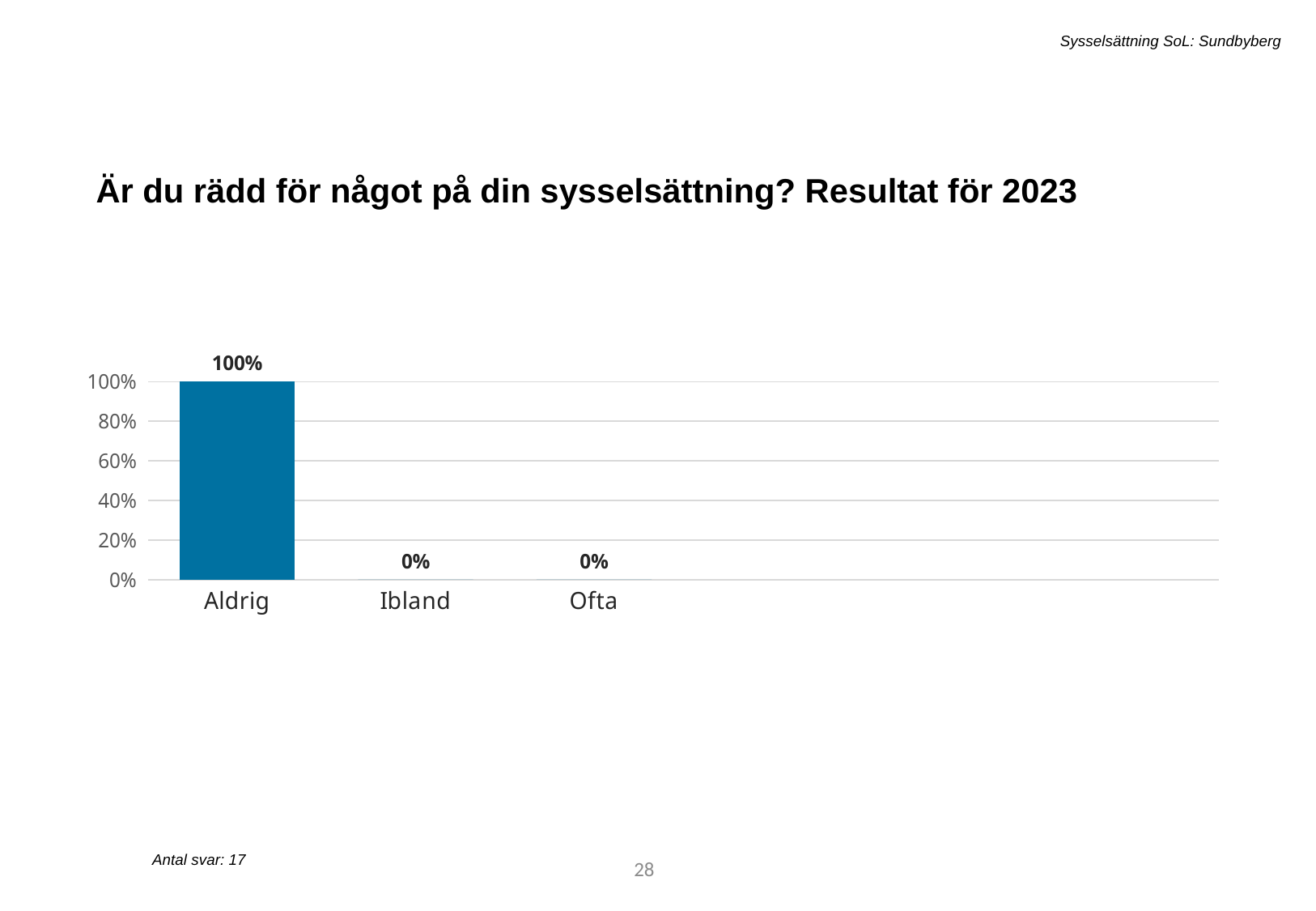
What is the title of the chart? Är du rädd för något på din sysselsättning? Resultat för 2023 How many responses (Antal svar) does the slide report? 17 What is the value for Ibland? 0% What is the value for Ofta? 0% Which category has the highest value? Aldrig Is the value for Aldrig greater or less than 80%? greater How many categories are shown on the x axis? 3 What kind of chart is shown on the slide? bar chart What is the value for Aldrig? 100% Do the values rise or fall from Aldrig to Ofta along the x axis? fall Which is larger, the value for Aldrig or the value for Ofta? Aldrig What is the difference between the values for Aldrig and Ibland? 100%